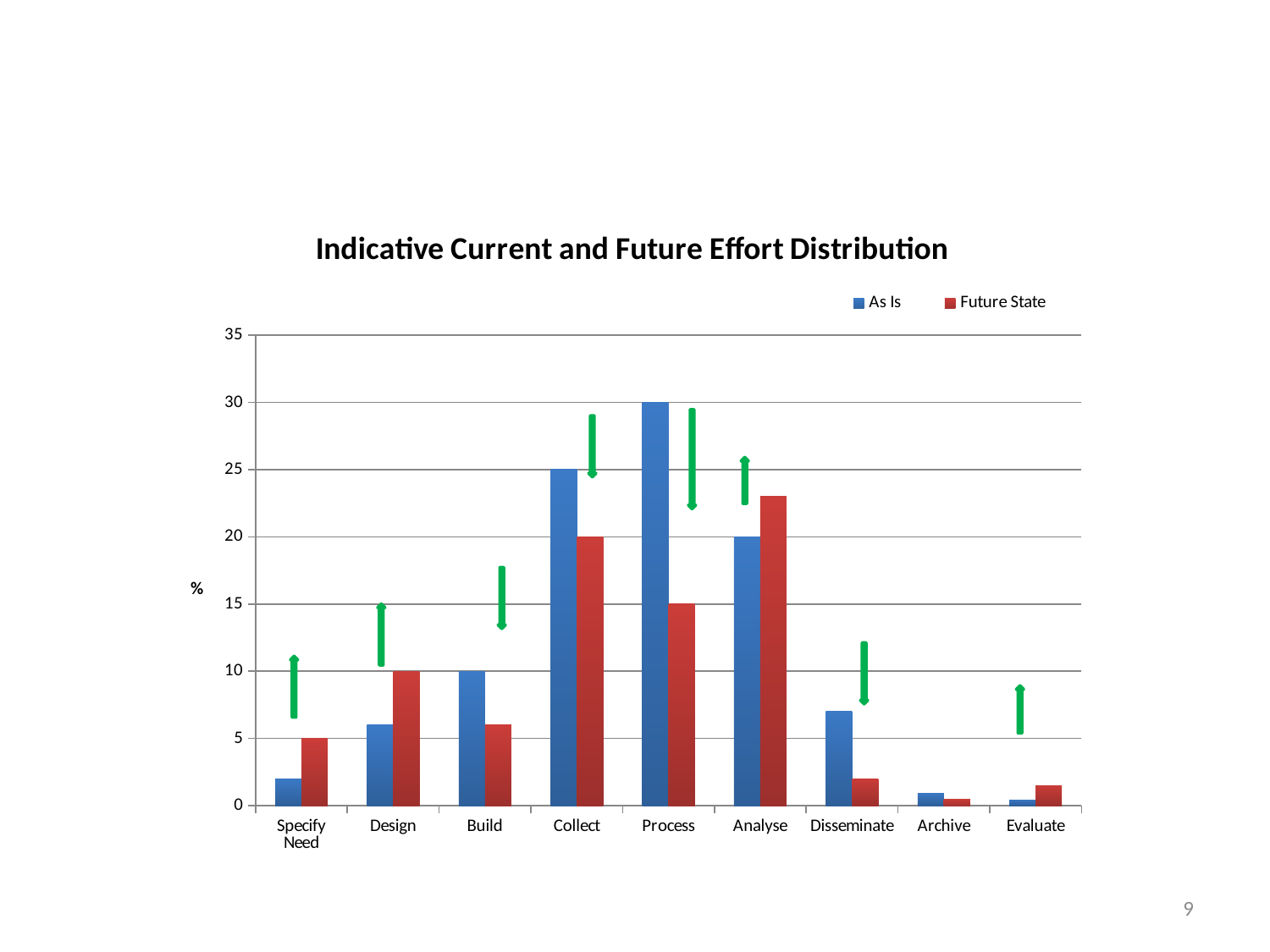
What is the difference between the As Is and Future State values for Process? 15 Is the Future State value for Analyse greater or less than 20? greater What is the As Is value for Collect? 25 Which category has the highest As Is value? Process What is the title of the chart? Indicative Current and Future Effort Distribution How many series does the legend list? 2 How many categories are shown on the x axis? 9 Which category has the highest Future State value? Analyse What is the Future State value for Process? 15 What kind of chart is shown on the slide? bar chart For Collect, which is larger: the As Is value or the Future State value? As Is What is the As Is value for Process? 30